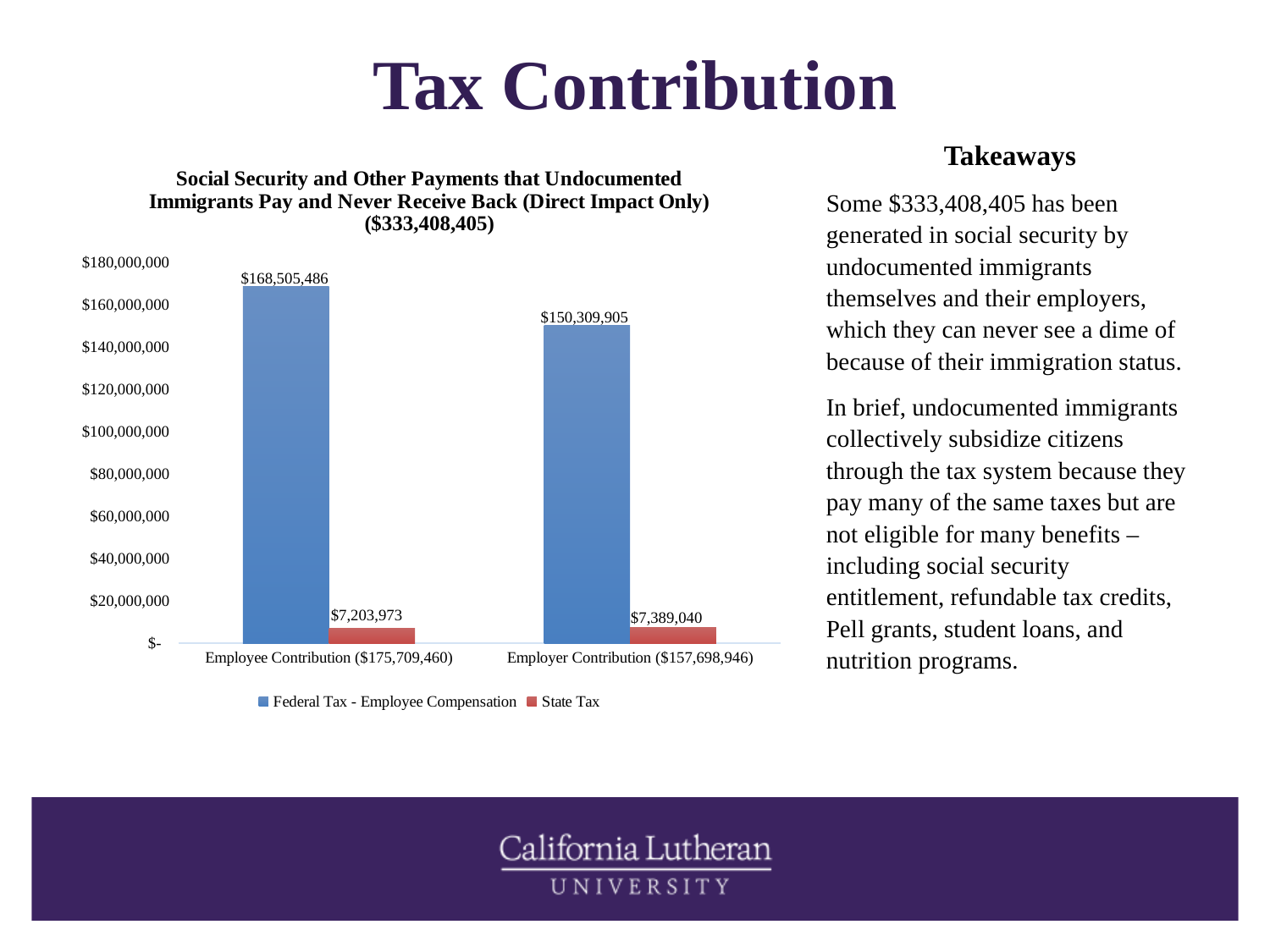
What is the State Tax value for Employer Contribution? $7,389,040 Which category has the higher Federal Tax - Employee Compensation value? Employee Contribution Which bar in the chart has the lowest value? State Tax for Employee Contribution What is the Federal Tax - Employee Compensation value for Employer Contribution? $150,309,905 Is the Federal Tax - Employee Compensation value for Employer Contribution greater or less than $140,000,000? greater What is the Federal Tax - Employee Compensation value for Employee Contribution? $168,505,486 What is the difference between the State Tax values for Employer Contribution and Employee Contribution? $185,067 What is the State Tax value for Employee Contribution? $7,203,973 How many series does the legend list? 2 Is the State Tax value for Employer Contribution larger or smaller than the State Tax value for Employee Contribution? larger What type of chart is shown on the slide? Bar chart What is the difference between the Federal Tax - Employee Compensation values for Employee Contribution and Employer Contribution? $18,195,581